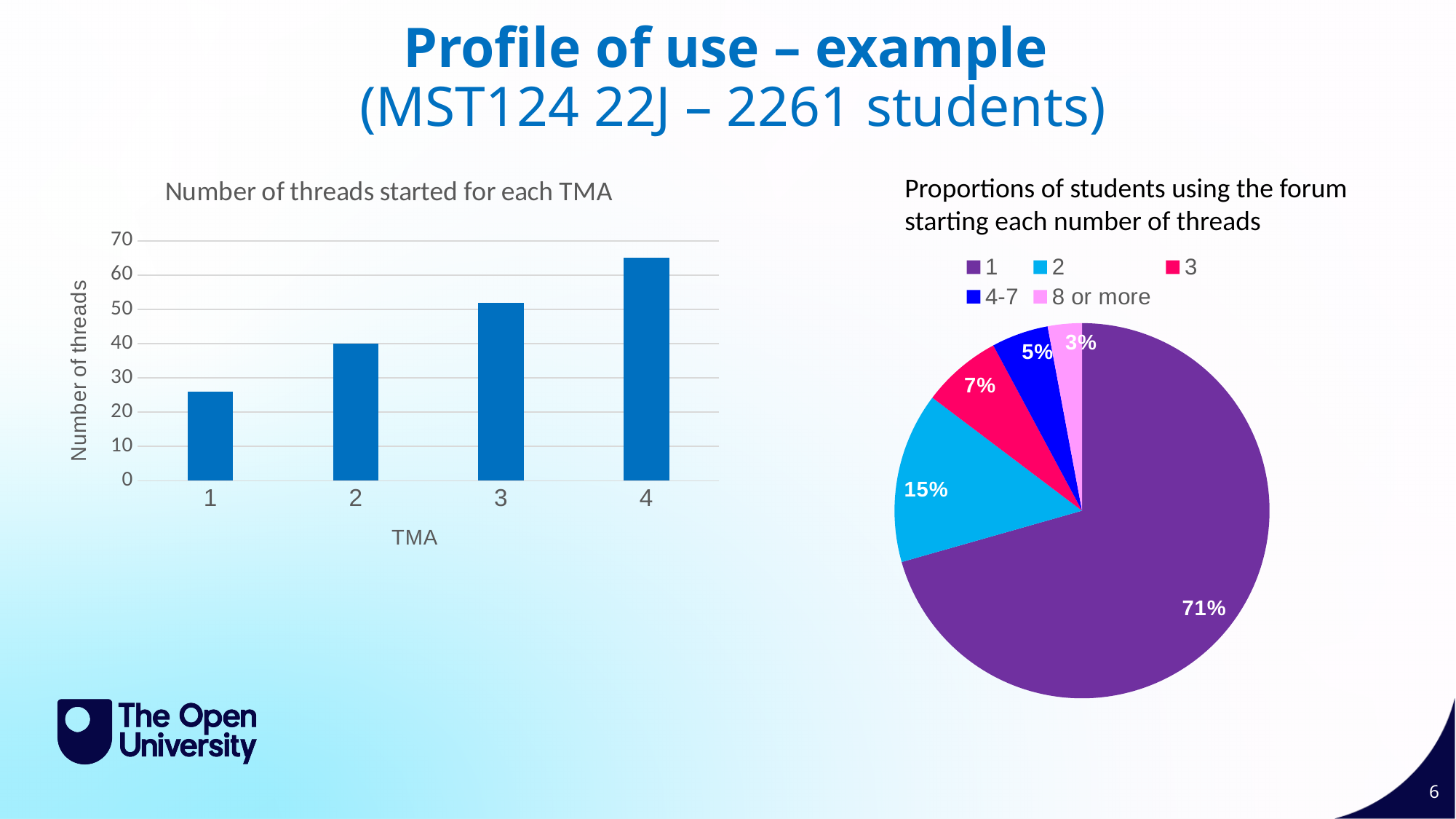
How many TMAs are shown in the bar chart 'Number of threads started for each TMA'? 4 In the bar chart 'Number of threads started for each TMA', which TMA has the lowest number of threads? 1 In the bar chart 'Number of threads started for each TMA', is the value for TMA 1 greater or less than 30? less In the pie chart 'Proportions of students using the forum starting each number of threads', what share of students started 8 or more threads? 3% In the bar chart 'Number of threads started for each TMA', is the value for TMA 3 greater or less than 50? greater In the bar chart 'Number of threads started for each TMA', which TMA has the highest number of threads? 4 In the bar chart 'Number of threads started for each TMA', is the value for TMA 4 greater or less than 60? greater In the pie chart 'Proportions of students using the forum starting each number of threads', what share of students started 1 thread? 71% How many categories does the legend of the pie chart 'Proportions of students using the forum starting each number of threads' list? 5 In the pie chart 'Proportions of students using the forum starting each number of threads', what is the difference between the share for 2 threads and the share for 3 threads? 8% What kind of chart is 'Number of threads started for each TMA'? bar chart In the bar chart 'Number of threads started for each TMA', do the values rise or fall from TMA 1 to TMA 4? rise